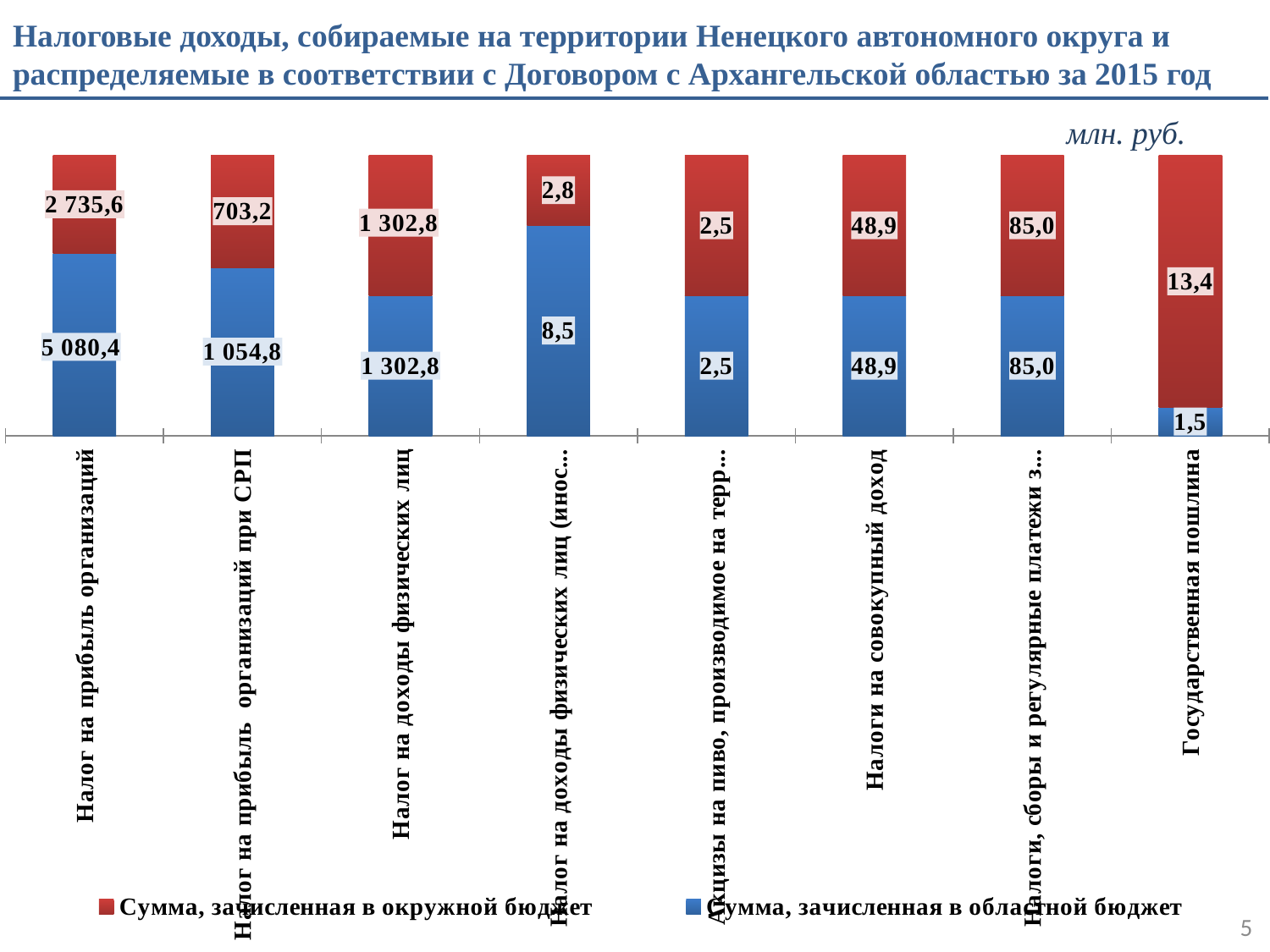
Что больше по государственной пошлине: сумма, зачисленная в окружной бюджет, или сумма, зачисленная в областной бюджет? Сумма, зачисленная в окружной бюджет Сколько рядов данных указано в легенде диаграммы? 2 Сколько видов налогов (категорий) показано на диаграмме? 8 По какому виду налога сумма, зачисленная в областной бюджет, наибольшая? Налог на прибыль организаций Какая сумма по налогу на прибыль организаций при СРП зачислена в областной бюджет? 1 054,8 На сколько сумма по налогу на прибыль организаций, зачисленная в областной бюджет, больше суммы, зачисленной в окружной бюджет? 2 344,8 Какова общая сумма по налогу на прибыль организаций при СРП (окружной и областной бюджет вместе)? 1 758,0 Какого типа эта диаграмма? Столбчатая диаграмма с накоплением Какая сумма по налогу на прибыль организаций зачислена в областной бюджет? 5 080,4 Какая сумма по государственной пошлине зачислена в окружной бюджет? 13,4 По какому виду налога сумма, зачисленная в областной бюджет, наименьшая? Государственная пошлина Какая сумма по налогу на прибыль организаций зачислена в окружной бюджет? 2 735,6